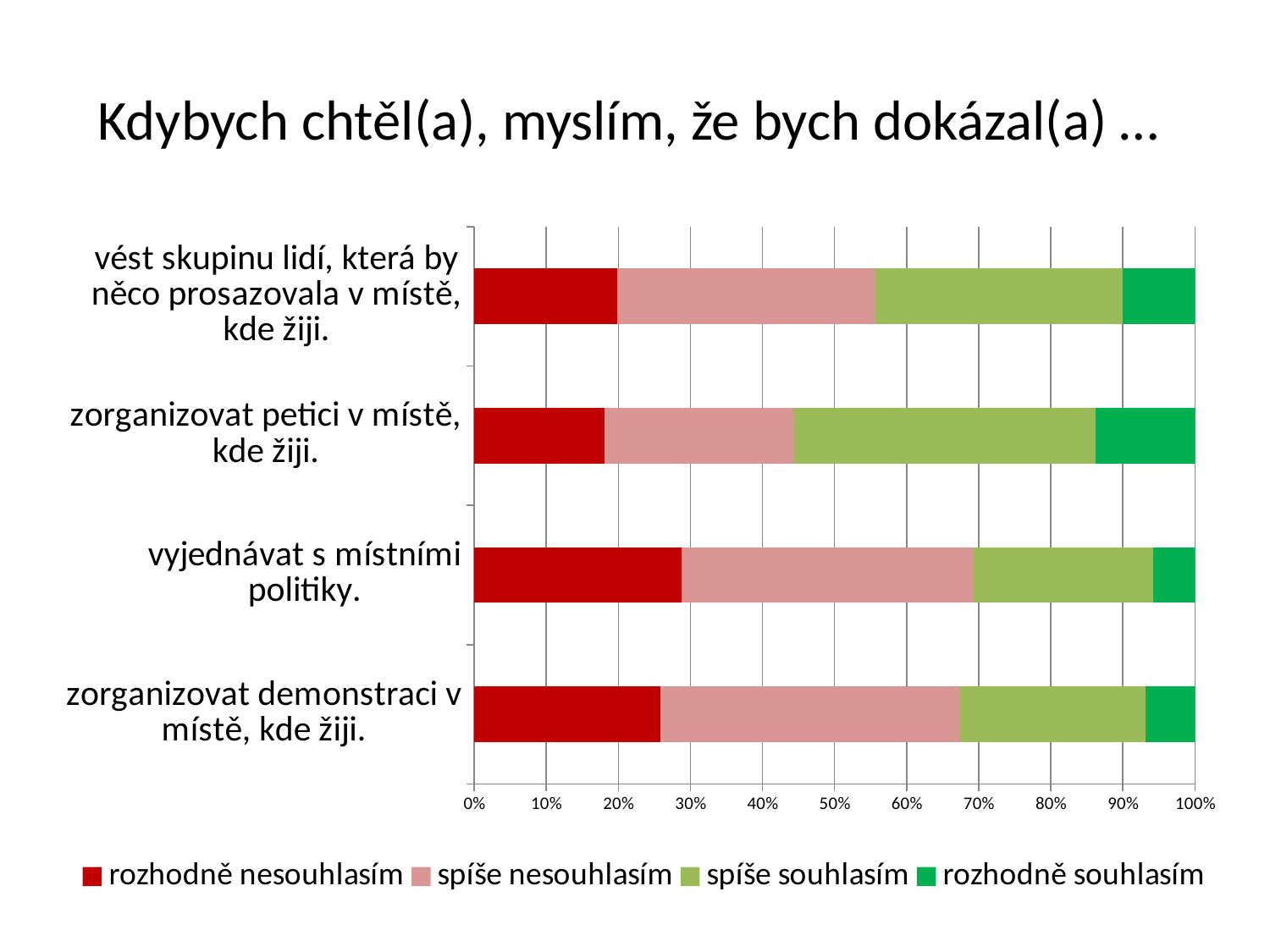
Is the 'rozhodně souhlasím' value for 'vyjednávat s místními politiky.' greater or less than 10%? less What kind of chart is shown on the slide? stacked bar chart Is the 'rozhodně nesouhlasím' value for 'zorganizovat demonstraci v místě, kde žiji.' greater or less than 20%? greater What is the title of the chart on the slide? Kdybych chtěl(a), myslím, že bych dokázal(a) … Is the 'rozhodně nesouhlasím' value for 'vyjednávat s místními politiky.' greater or less than 20%? greater How many categories (statements) are plotted on the chart? 4 Which category has the largest 'spíše souhlasím' segment? zorganizovat petici v místě, kde žiji. Which category has the largest 'rozhodně souhlasím' segment? zorganizovat petici v místě, kde žiji. Which has the larger 'rozhodně nesouhlasím' segment: 'vyjednávat s místními politiky.' or 'zorganizovat petici v místě, kde žiji.'? vyjednávat s místními politiky. Which legend entry is shown in dark red? rozhodně nesouhlasím How many series does the legend list? 4